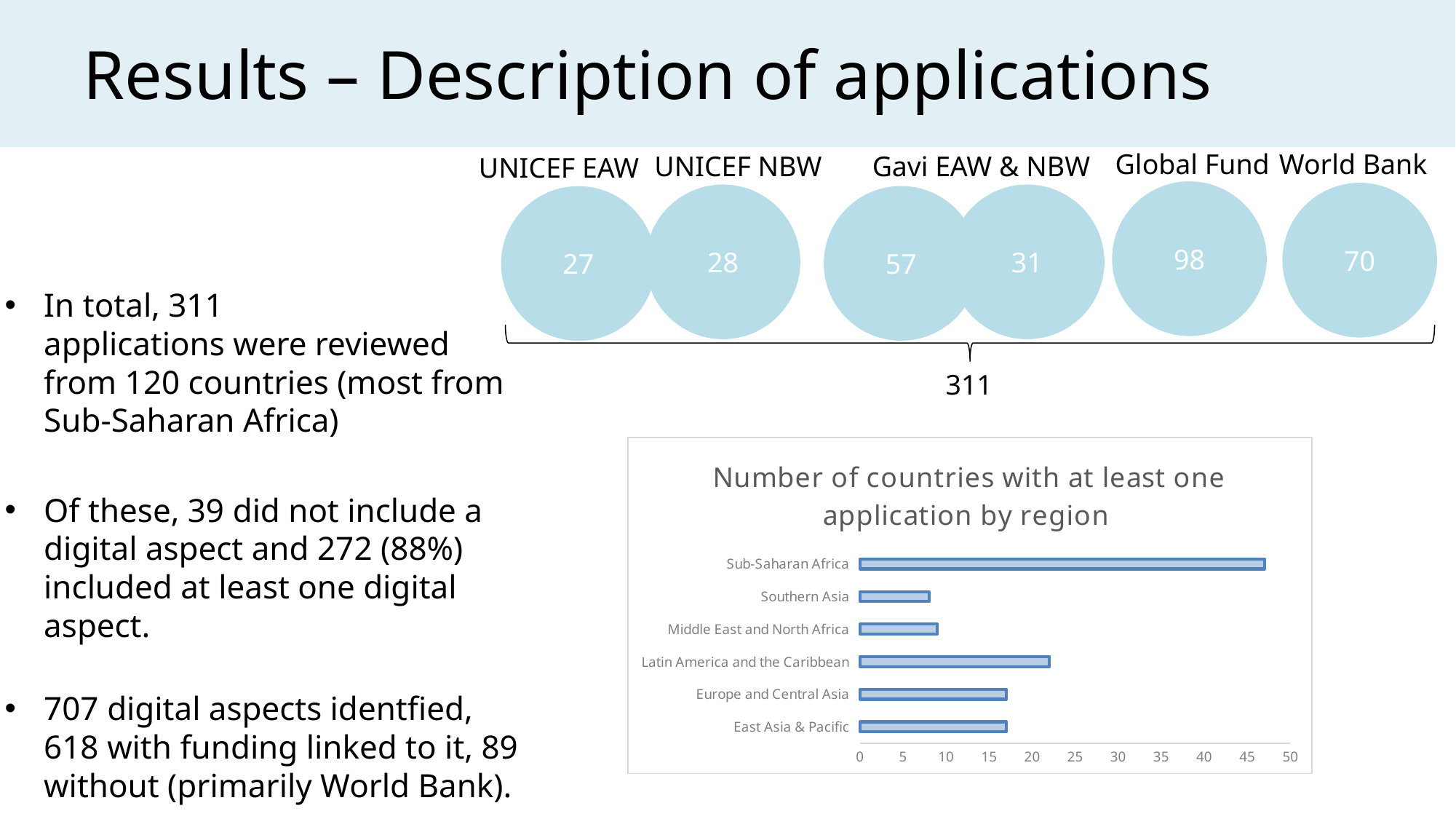
Which has more countries with at least one application, Sub-Saharan Africa or Latin America and the Caribbean? Sub-Saharan Africa Is the value for Southern Asia greater or less than 10? less How many regions are shown in the bar chart? 6 Is the value for Sub-Saharan Africa greater or less than 40? greater Which region has the highest number of countries with at least one application? Sub-Saharan Africa Is the value for Middle East and North Africa greater or less than 15? less What is the maximum value shown on the x axis of the bar chart? 50 What is the title of the bar chart? Number of countries with at least one application by region What kind of chart is shown on the slide? bar chart Which has more countries with at least one application, Latin America and the Caribbean or Europe and Central Asia? Latin America and the Caribbean